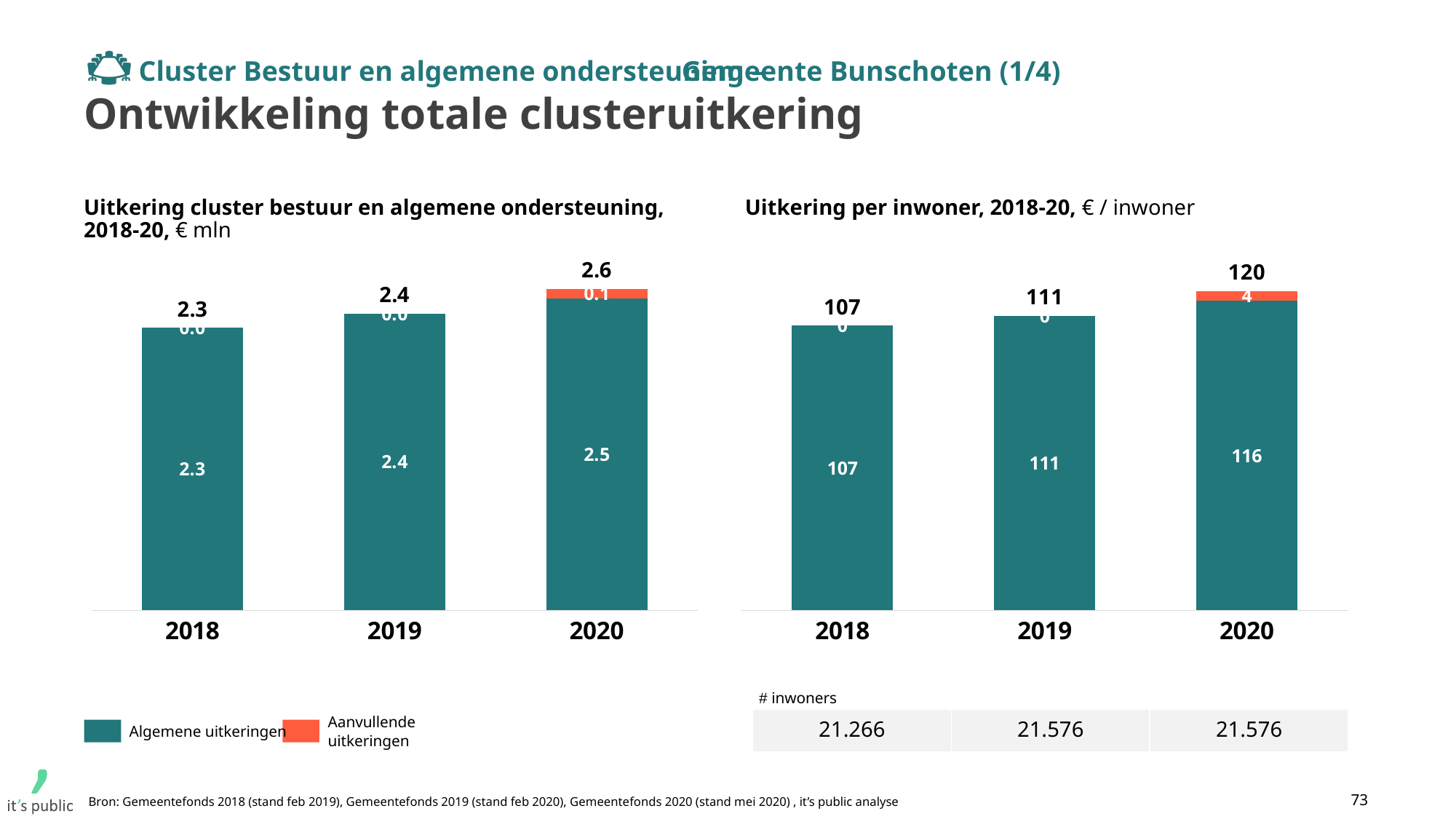
In the right chart (Uitkering per inwoner), do the totals rise or fall from 2018 to 2020? rise In the left chart (Uitkering cluster bestuur en algemene ondersteuning), what is the value of Algemene uitkeringen in 2019? 2.4 How many series does the legend list? 2 In the right chart (Uitkering per inwoner), what is the value of Aanvullende uitkeringen in 2020? 4 In the right chart (Uitkering per inwoner), which year has the lowest total? 2018 In the left chart (Uitkering cluster bestuur en algemene ondersteuning), what is the value of Aanvullende uitkeringen in 2020? 0.1 In the right chart (Uitkering per inwoner), what is the total value for 2020? 120 In the right chart (Uitkering per inwoner), what is the difference between the totals for 2019 and 2018? 4 In the right chart (Uitkering per inwoner), what is the value of Algemene uitkeringen in 2020? 116 In the left chart (Uitkering cluster bestuur en algemene ondersteuning), which year has the highest total? 2020 In the left chart (Uitkering cluster bestuur en algemene ondersteuning), what is the total value for 2020? 2.6 In the left chart (Uitkering cluster bestuur en algemene ondersteuning), what is the difference between the totals for 2020 and 2018? 0.3